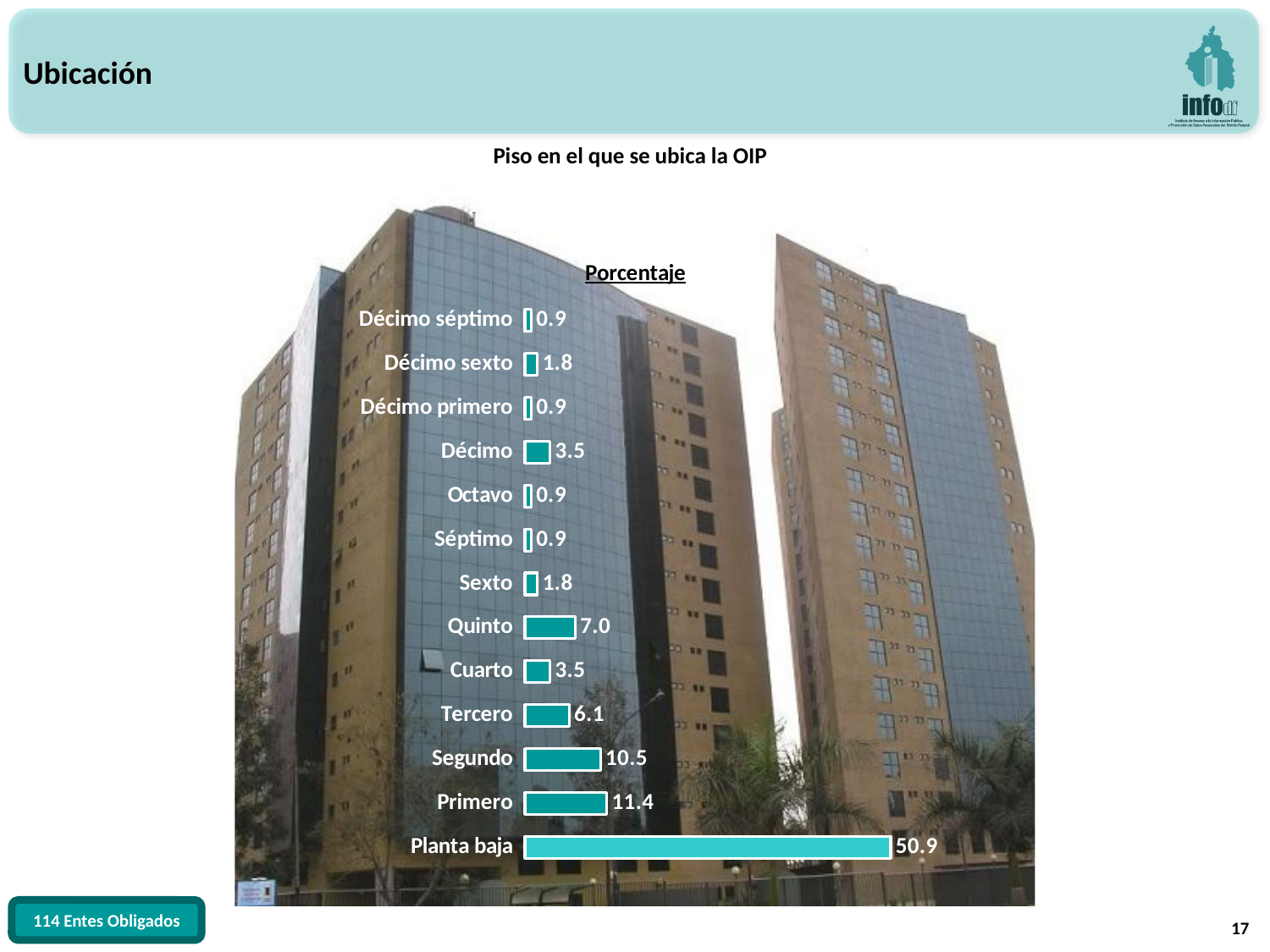
What is the title of the chart? Porcentaje Which is larger, the value for Tercero or the value for Cuarto? Tercero How many floor categories are shown in the chart? 13 What is the value for Segundo? 10.5 What is the value for Quinto? 7.0 What is the value for Planta baja? 50.9 Which floor has the highest value? Planta baja What is the value for Décimo sexto? 1.8 What is the difference between the values for Planta baja and Primero? 39.5 Which is larger, the value for Quinto or the value for Décimo? Quinto What is the difference between the values for Primero and Segundo? 0.9 What kind of chart is shown on the slide? Bar chart